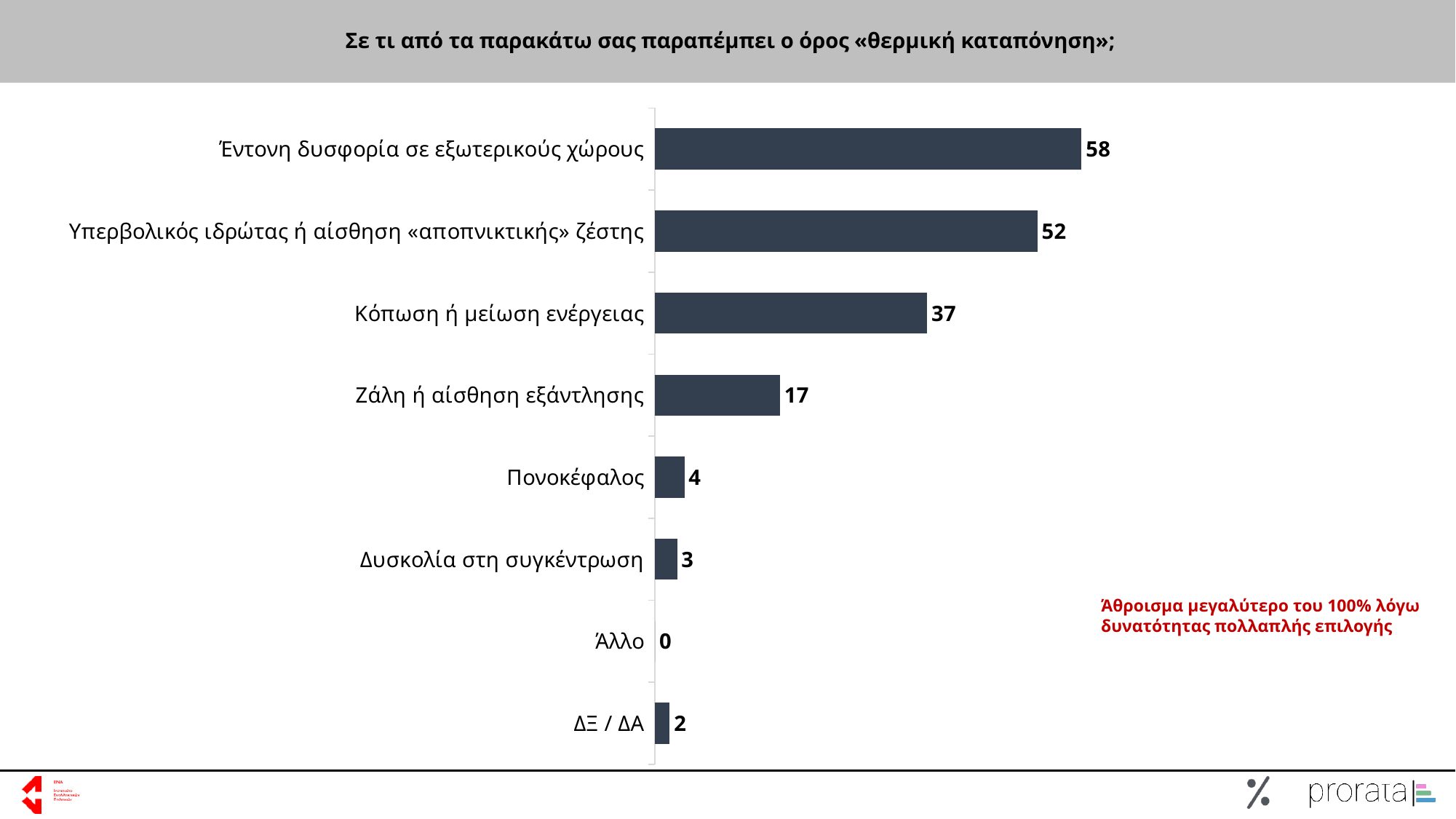
How many categories are shown in the chart? 8 Which is larger, «Πονοκέφαλος» or «Δυσκολία στη συγκέντρωση»? Πονοκέφαλος What is the value for «Έντονη δυσφορία σε εξωτερικούς χώρους»? 58 Which category has the highest value? Έντονη δυσφορία σε εξωτερικούς χώρους What kind of chart is shown on the slide? Bar chart What is the difference between «Κόπωση ή μείωση ενέργειας» and «Ζάλη ή αίσθηση εξάντλησης»? 20 What is the value for «Πονοκέφαλος»? 4 What is the value for «Κόπωση ή μείωση ενέργειας»? 37 What is the title of the chart? Σε τι από τα παρακάτω σας παραπέμπει ο όρος «θερμική καταπόνηση»; Which category has the lowest value? Άλλο What is the difference between «Έντονη δυσφορία σε εξωτερικούς χώρους» and «Υπερβολικός ιδρώτας ή αίσθηση «αποπνικτικής» ζέστης»? 6 What is the value for «ΔΞ / ΔΑ»? 2